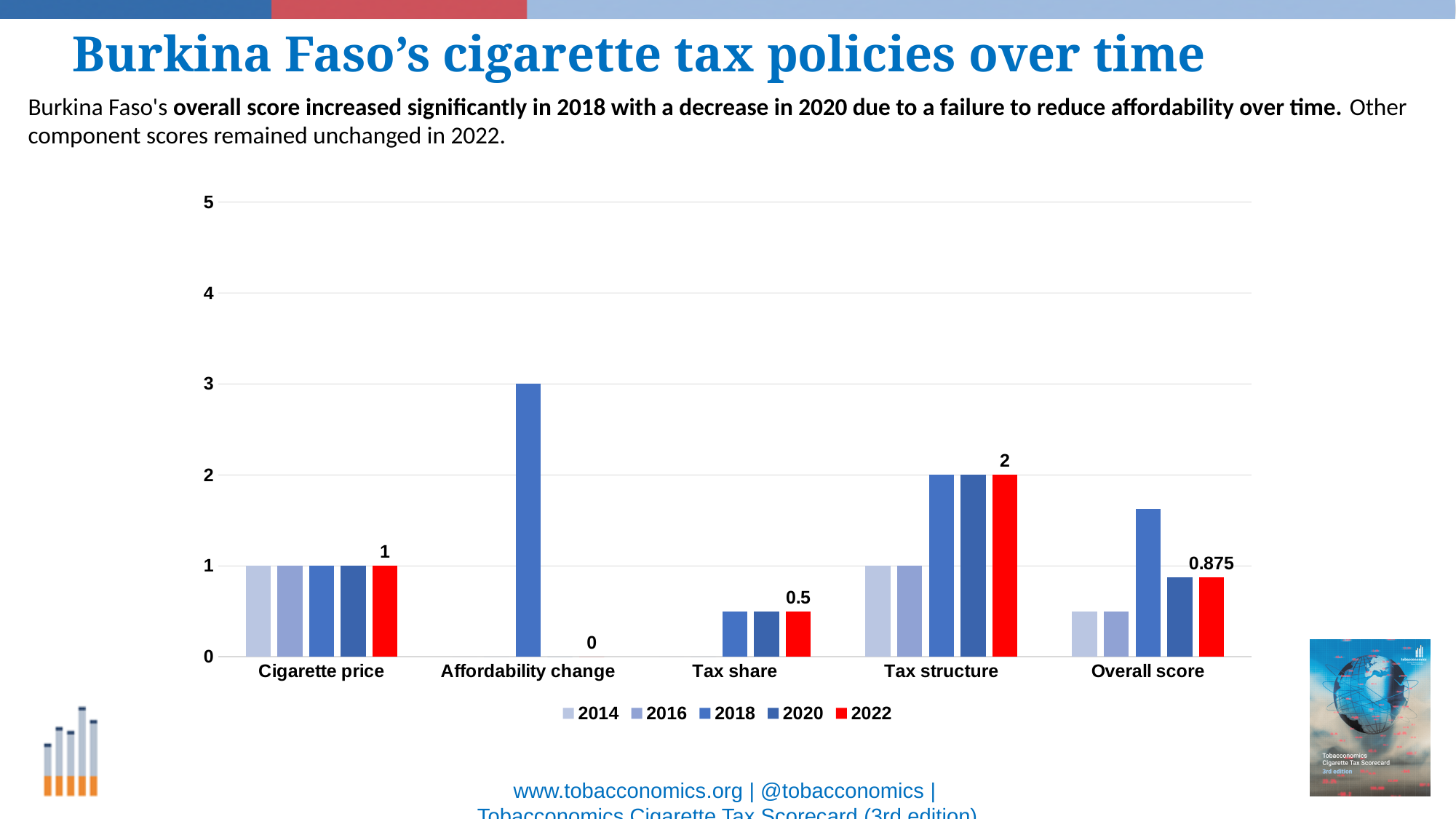
What is the 2022 value for Overall score? 0.875 Is the 2018 value for Overall score greater or less than 1? greater What kind of chart is shown on the slide? bar chart What is the difference between the 2022 values for Tax structure and Tax share? 1.5 What is the 2022 value for Tax structure? 2 What is the 2018 value for Affordability change? 3 Which is larger in 2022: Cigarette price or Overall score? Cigarette price How many categories are shown on the x axis? 5 Which category has the lowest 2022 value? Affordability change Which category has the highest 2022 value? Tax structure What is the 2022 value for Affordability change? 0 How many series does the legend list? 5